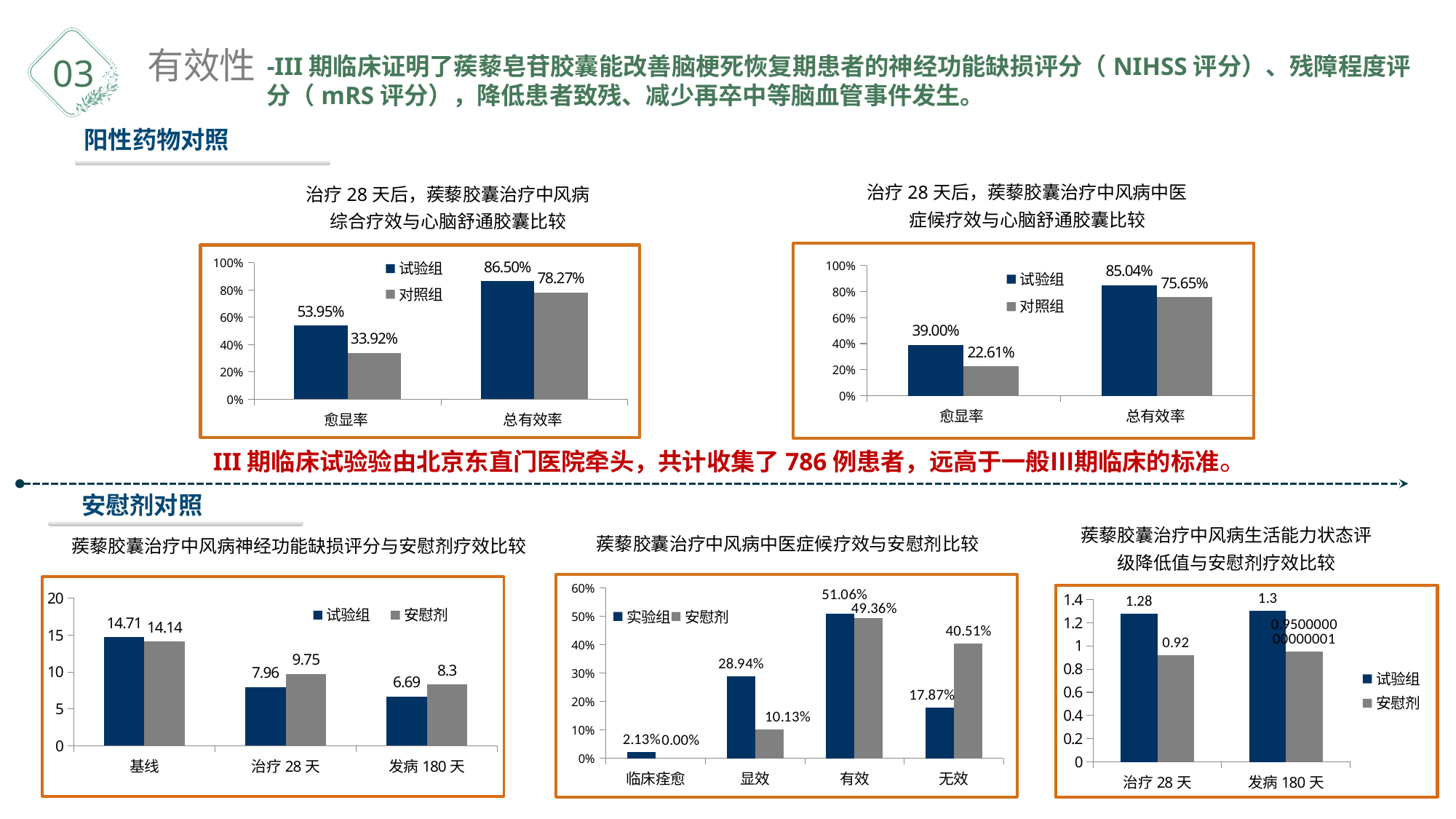
In the bottom-middle chart (中医症候疗效与安慰剂比较), which category has the highest value for 实验组? 有效 In the top-left chart (治疗28天后，蒺藜胶囊治疗中风病综合疗效与心脑舒通胶囊比较), what is the 愈显率 value for 试验组? 53.95% In the bottom-right chart (生活能力状态评级降低值与安慰剂疗效比较), what is the value for 试验组 at 发病180天? 1.3 In the bottom-middle chart (中医症候疗效与安慰剂比较), what is the difference between 实验组 and 安慰剂 for 显效? 18.81% What type of chart is the bottom-right chart (生活能力状态评级降低值与安慰剂疗效比较)? Bar chart In the top-right chart (中医症候疗效与心脑舒通胶囊比较), what is the 愈显率 value for 对照组? 22.61% In the bottom-left chart (神经功能缺损评分与安慰剂疗效比较), what is the value for 安慰剂 at 治疗28天? 9.75 In the top-left chart (综合疗效与心脑舒通胶囊比较), what is the difference between 试验组 and 对照组 for 总有效率? 8.23% In the bottom-middle chart (中医症候疗效与安慰剂比较), what is the 无效 value for 安慰剂? 40.51% In the bottom-left chart (神经功能缺损评分与安慰剂疗效比较), how many categories are shown on the x axis? 3 In the top-right chart (中医症候疗效与心脑舒通胶囊比较), which group has the higher 总有效率, 试验组 or 对照组? 试验组 In the bottom-left chart (神经功能缺损评分与安慰剂疗效比较), how do the 试验组 values change from 基线 to 发病180天? They fall